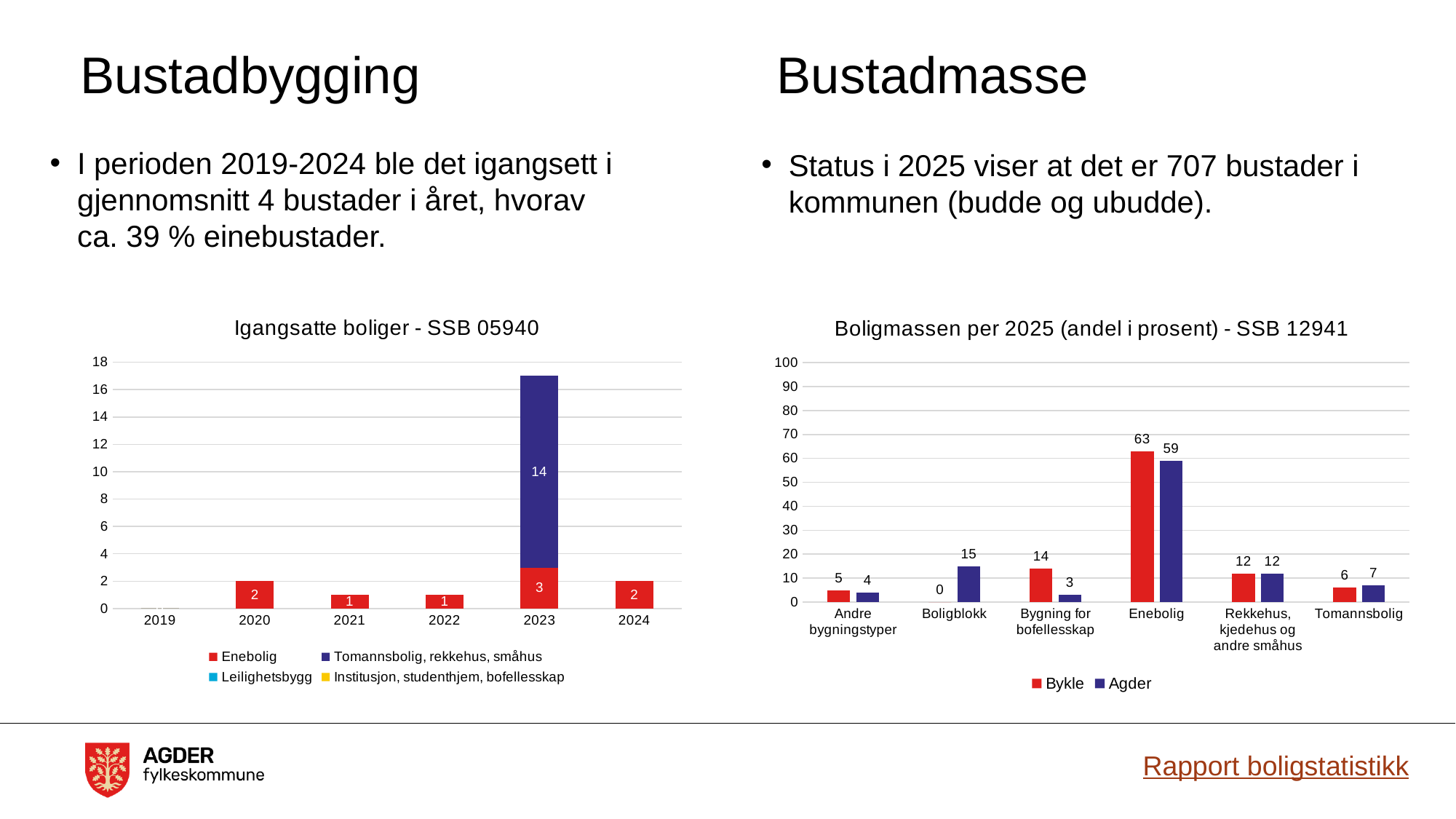
In the chart 'Boligmassen per 2025 (andel i prosent) - SSB 12941', how many categories are shown on the x axis? 6 In the chart 'Boligmassen per 2025 (andel i prosent) - SSB 12941', what is the value for Agder for Boligblokk? 15 In the chart 'Boligmassen per 2025 (andel i prosent) - SSB 12941', which is larger for Tomannsbolig, Bykle or Agder? Agder In the chart 'Igangsatte boliger - SSB 05940', which year has the highest total? 2023 In the chart 'Boligmassen per 2025 (andel i prosent) - SSB 12941', which category has the lowest value for Bykle? Boligblokk In the chart 'Igangsatte boliger - SSB 05940', what is the value for Enebolig in 2020? 2 In the chart 'Igangsatte boliger - SSB 05940', what is the value for Tomannsbolig, rekkehus, småhus in 2023? 14 What kind of chart is 'Igangsatte boliger - SSB 05940'? Stacked bar chart In the chart 'Boligmassen per 2025 (andel i prosent) - SSB 12941', what is the value for Bykle for Enebolig? 63 In the chart 'Boligmassen per 2025 (andel i prosent) - SSB 12941', what is the difference between Bykle and Agder for Bygning for bofellesskap? 11 In the chart 'Igangsatte boliger - SSB 05940', how many series does the legend list? 4 In the chart 'Igangsatte boliger - SSB 05940', what is the total of the stacked bar for 2023? 17